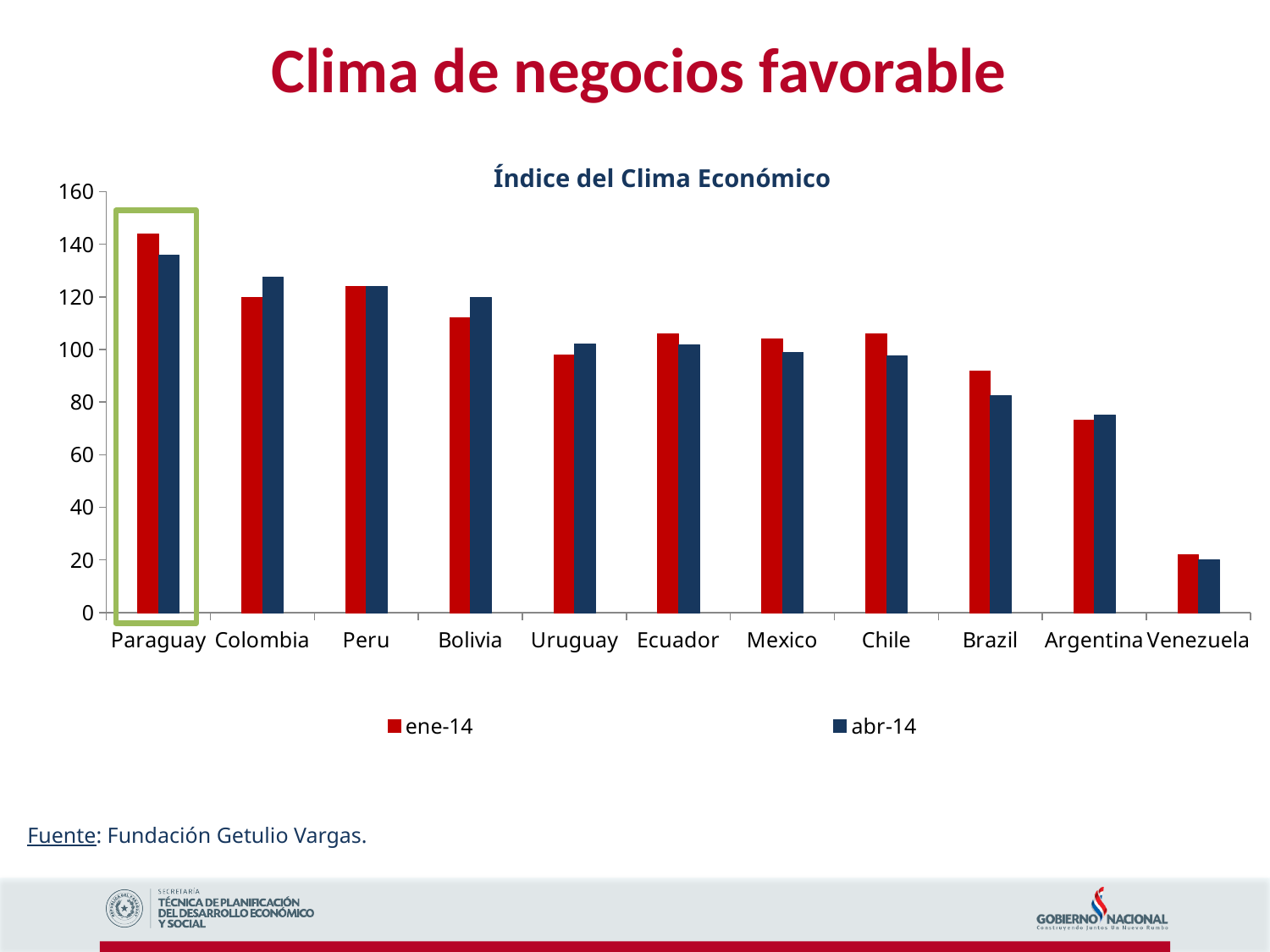
Which country has the highest ene-14 value? Paraguay How many series does the legend list? 2 For Colombia, which is larger: the ene-14 value or the abr-14 value? abr-14 Do the ene-14 values generally rise or fall from Paraguay to Venezuela along the x axis? fall What kind of chart is shown on the slide? bar chart What is the title of the chart? Índice del Clima Económico Is the abr-14 value for Paraguay greater or less than 120? greater Is the ene-14 value for Venezuela greater or less than 40? less How many countries are shown on the x axis of the chart? 11 For Paraguay, which is larger: the ene-14 value or the abr-14 value? ene-14 Is the abr-14 value for Brazil greater or less than 100? less Which country has the lowest abr-14 value? Venezuela